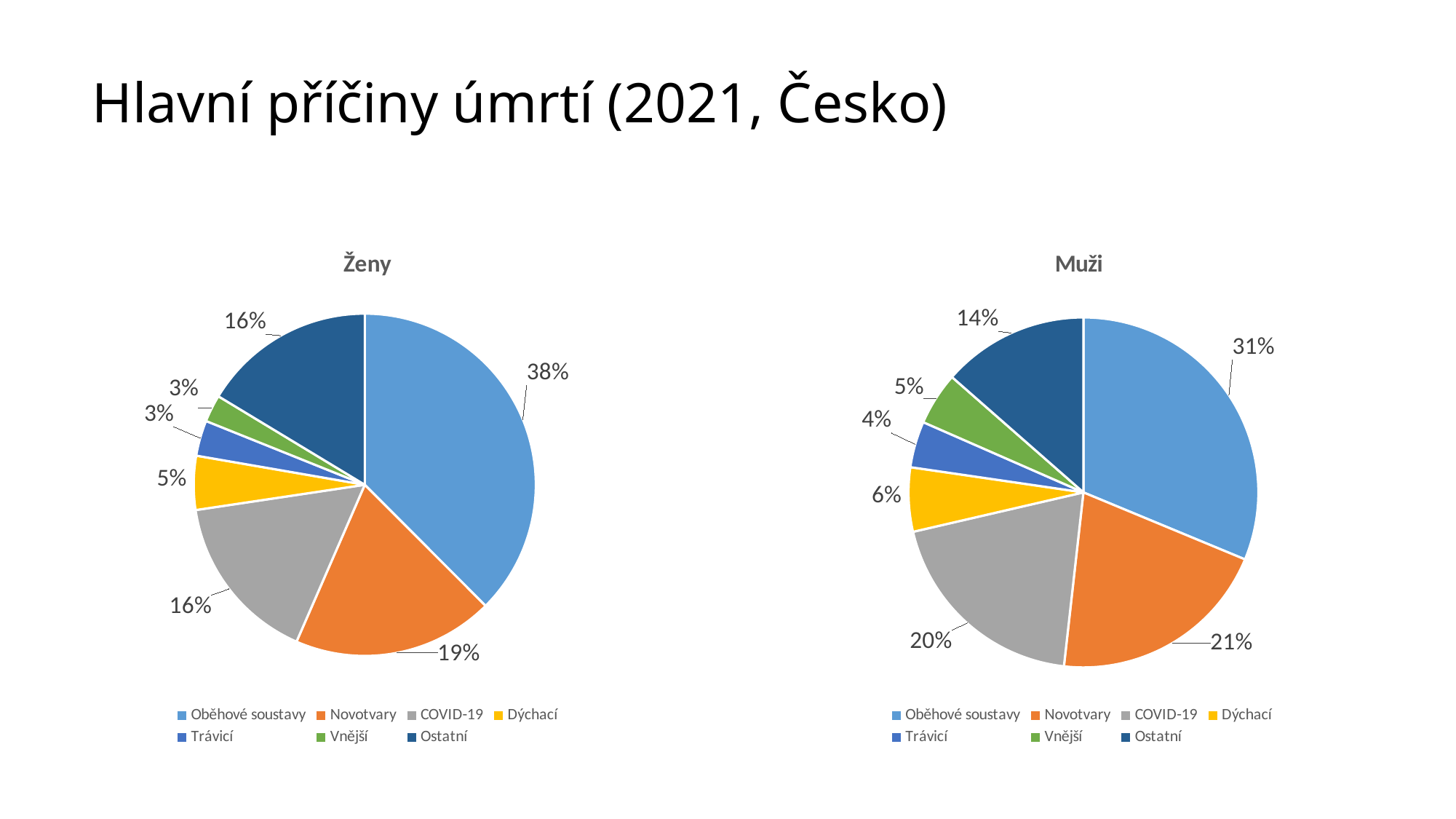
In the "Muži" chart, what is the difference between the Ostatní share and the Vnější share? 9% In the "Muži" chart, which category has the largest slice? Oběhové soustavy How many categories does the legend of the "Ženy" chart list? 7 In the "Muži" chart, what share is labelled for Novotvary? 21% In the "Ženy" chart, what share is labelled for Oběhové soustavy? 38% Which is larger: the COVID-19 share in the "Ženy" chart or the COVID-19 share in the "Muži" chart? Muži What is the title of the slide? Hlavní příčiny úmrtí (2021, Česko) In the "Ženy" chart, what is the difference between the Oběhové soustavy share and the Novotvary share? 19% What type of chart is the "Muži" chart? Pie chart In the "Muži" chart, which category has the smallest slice? Trávicí In the "Ženy" chart, what share is labelled for Dýchací? 5% In the "Muži" chart, what share is labelled for COVID-19? 20%